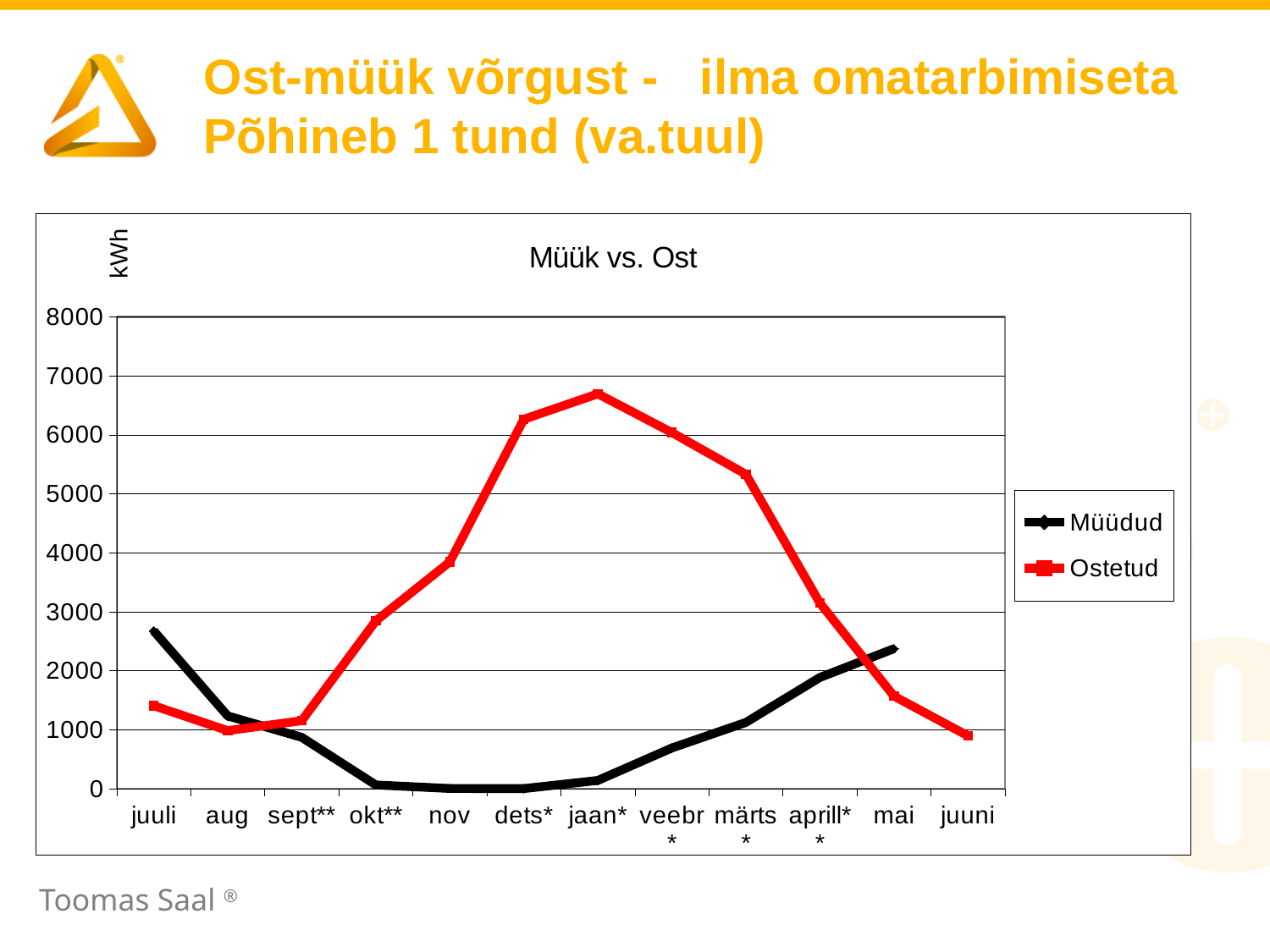
Is the Müüdud value for okt** greater or less than 1000? less How many months are shown along the x axis? 12 Is the Ostetud value for jaan* greater or less than 6000? greater How many series does the legend list? 2 In juuli, which series has the larger value, Müüdud or Ostetud? Müüdud In which month does the Ostetud series reach its highest value? jaan* Is the Ostetud value for juuni greater or less than 1000? less What is the title of the chart? Müük vs. Ost What kind of chart is shown on the slide? line chart Does the Ostetud series rise or fall from jaan* to juuni? fall In which month does the Müüdud series reach its highest value? juuli